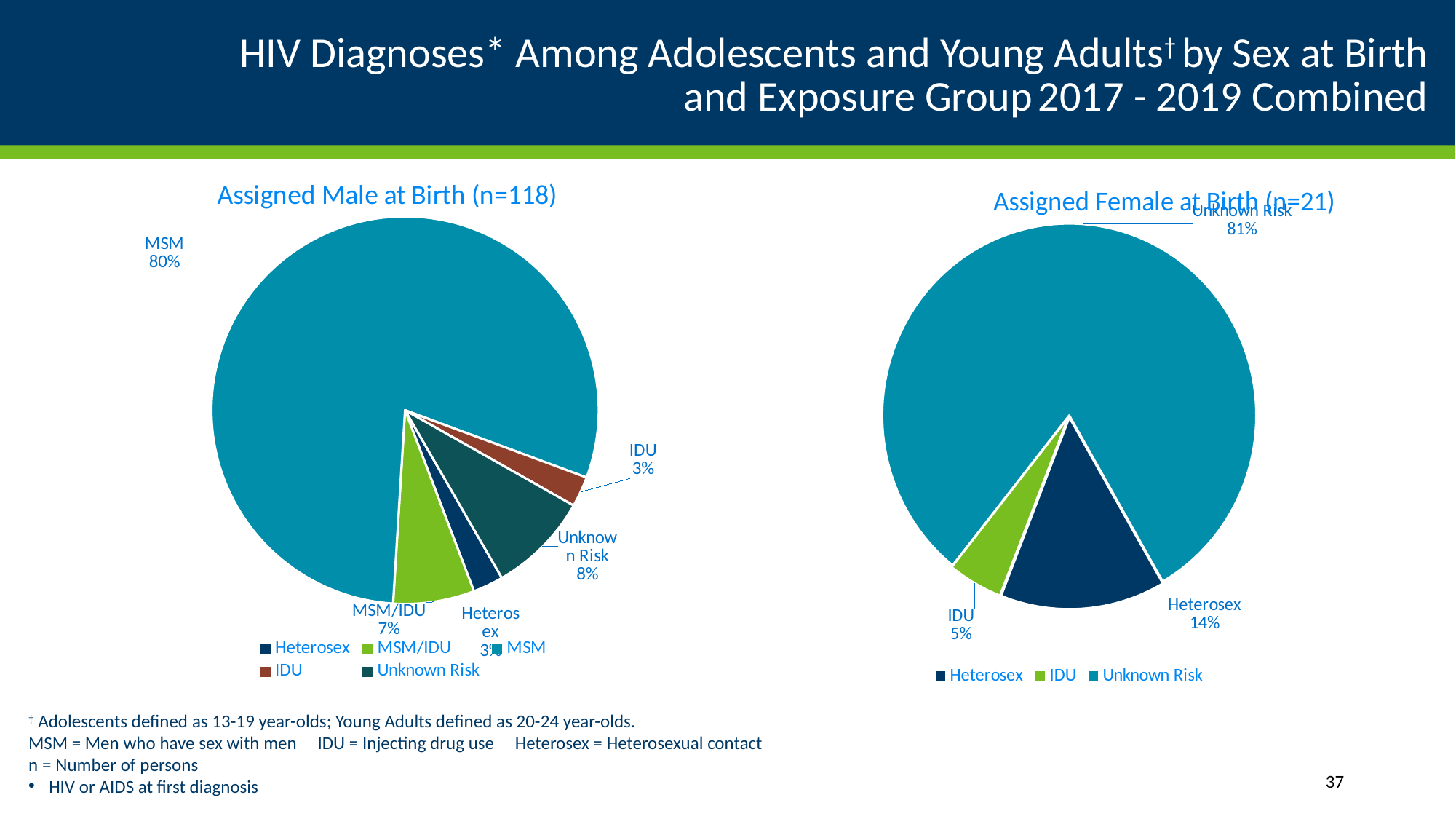
How many exposure groups does the legend of the Assigned Female at Birth chart list? 3 In the Assigned Female at Birth pie chart, what is the difference in percentage points between Unknown Risk and Heterosex? 67 In the Assigned Female at Birth pie chart, which exposure group has the smallest slice? IDU In the Assigned Female at Birth pie chart, what share of diagnoses is IDU? 5% In the Assigned Female at Birth pie chart, what share of diagnoses is Heterosex? 14% In the Assigned Male at Birth pie chart, what share of diagnoses is Unknown Risk? 8% In the Assigned Female at Birth pie chart, what share of diagnoses is Unknown Risk? 81% In the Assigned Male at Birth pie chart, which exposure group has the largest slice? MSM What type of chart is used for the Assigned Male at Birth data? Pie chart In the Assigned Male at Birth pie chart, what share of diagnoses is IDU? 3% In the Assigned Male at Birth pie chart, what share of diagnoses is MSM? 80% In the Assigned Male at Birth pie chart, what share of diagnoses is MSM/IDU? 7%